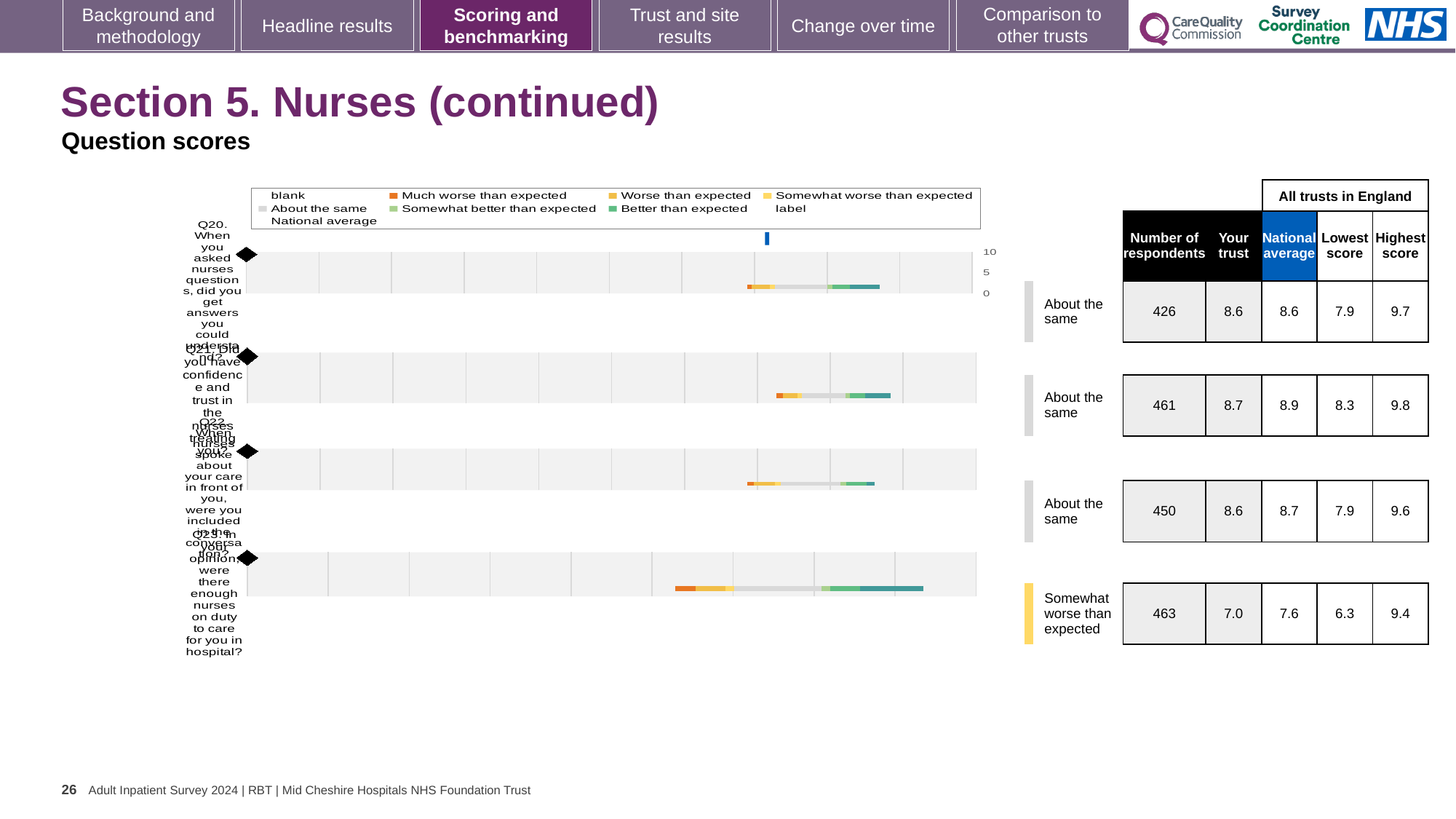
For Q23, how much higher is the national average than the 'Your trust' score? 0.6 What kind of chart is used to show the question scores on this slide? bar chart What benchmark category is shown for Q23? Somewhat worse than expected Which question has the lowest 'Your trust' score? Q23 How many questions (rows) are plotted in the chart? 4 Which question has the highest 'Your trust' score? Q21 What is the highest score among all trusts in England for Q21? 9.8 What is the national average score for Q21 (did you have confidence and trust in the nurses treating you)? 8.9 What is the lowest score among all trusts in England for Q23? 6.3 For Q22, which is larger: the 'Your trust' score or the national average? National average What is the 'Your trust' score for Q23 (were there enough nurses on duty to care for you in hospital)? 7.0 How many respondents answered Q22 (were you included in the conversation when nurses spoke about your care)? 450